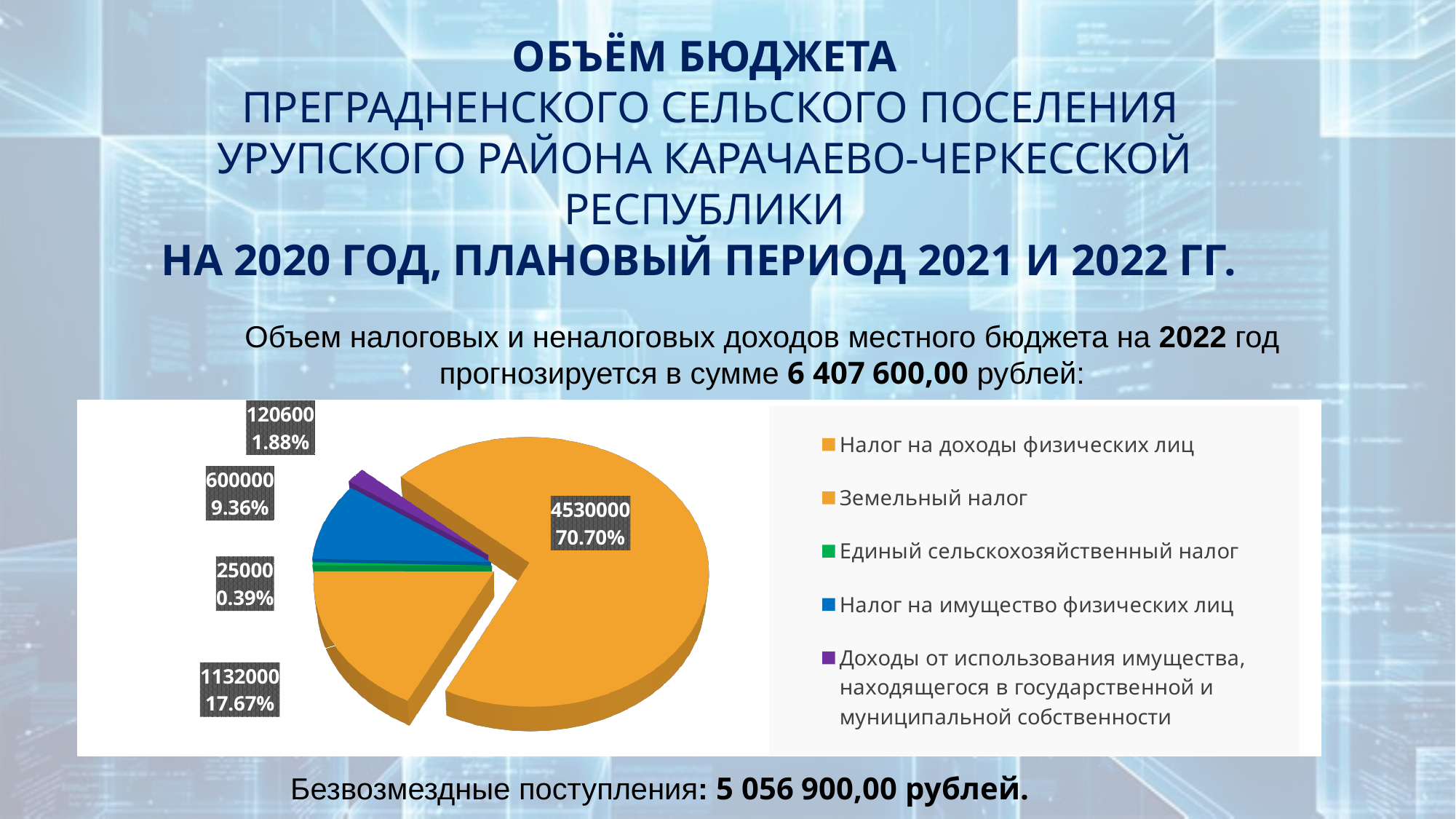
What share of the pie does Налог на имущество физических лиц have? 9.36% What value is shown for Налог на доходы физических лиц in the pie chart? 4530000 Which is larger: the value for Налог на имущество физических лиц or the value for Доходы от использования имущества, находящегося в государственной и муниципальной собственности? Налог на имущество физических лиц Which category has the smallest slice of the pie? Единый сельскохозяйственный налог What kind of chart is shown on the slide? pie chart What value is shown for Единый сельскохозяйственный налог? 25000 What is the difference between the values for Налог на доходы физических лиц and Земельный налог? 3398000 What share of the pie does Доходы от использования имущества, находящегося в государственной и муниципальной собственности have? 1.88% How many categories does the legend of the pie chart list? 5 Which category has the largest slice of the pie? Налог на доходы физических лиц What value is shown for Земельный налог in the pie chart? 1132000 What share of the pie does Налог на доходы физических лиц have? 70.70%